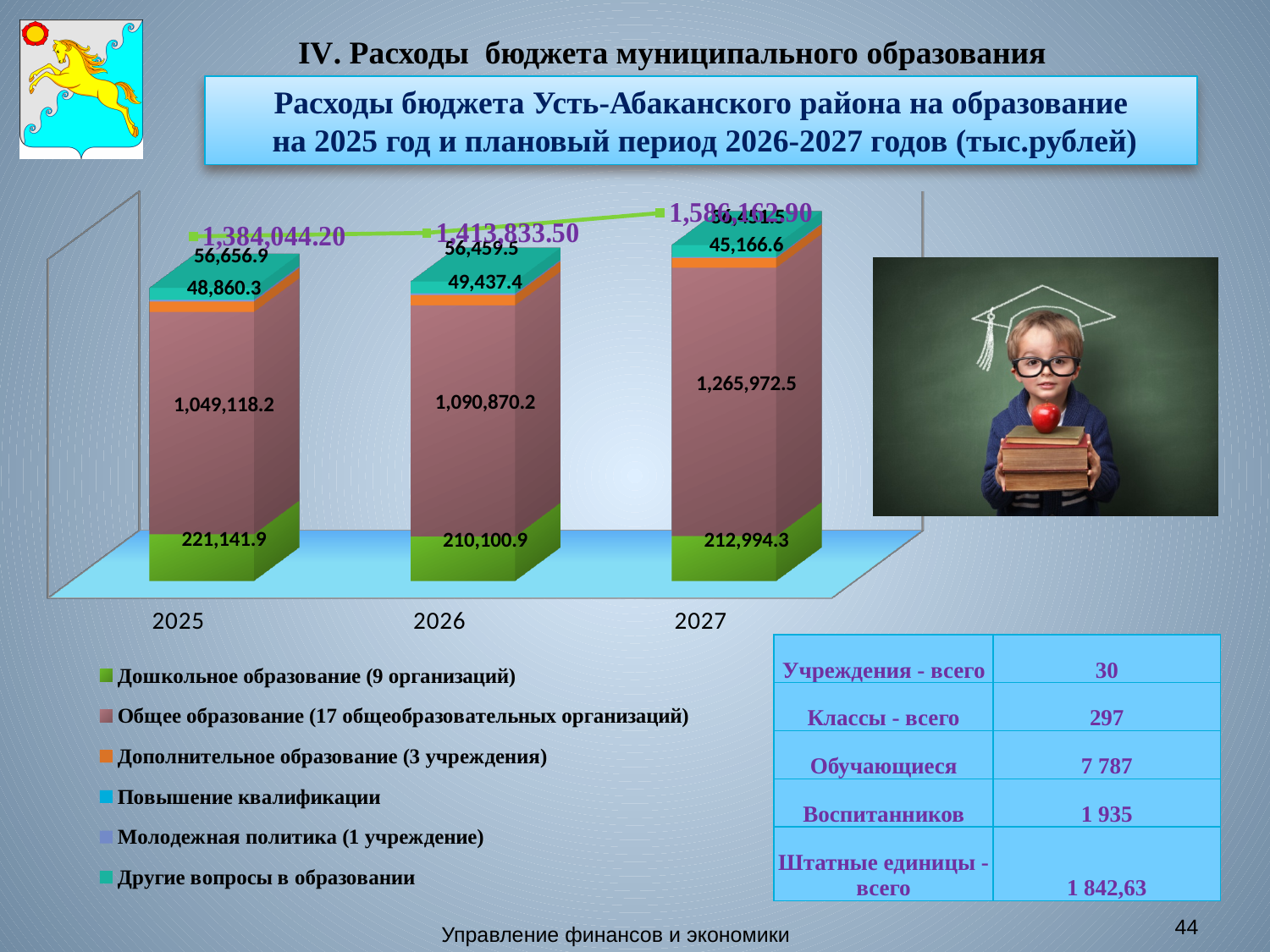
Which is larger: the value for Дошкольное образование in 2025 or in 2027? 2025 In which year is the value for Общее образование the highest? 2027 What is the total shown on the line for 2025? 1,384,044.20 What kind of chart is used to show the education expenditures? Stacked bar chart In which year is the value for Дошкольное образование the lowest? 2026 How many series does the legend list? 6 How many years are shown on the x axis of the chart? 3 What is the total shown on the line for 2026? 1,413,833.50 By how much does the total for 2026 exceed the total for 2025? 29,789.30 What is the value for Дошкольное образование in 2025? 221,141.9 By how much does the value for Общее образование in 2026 exceed that in 2025? 41,752.0 What is the value for Общее образование in 2027? 1,265,972.5